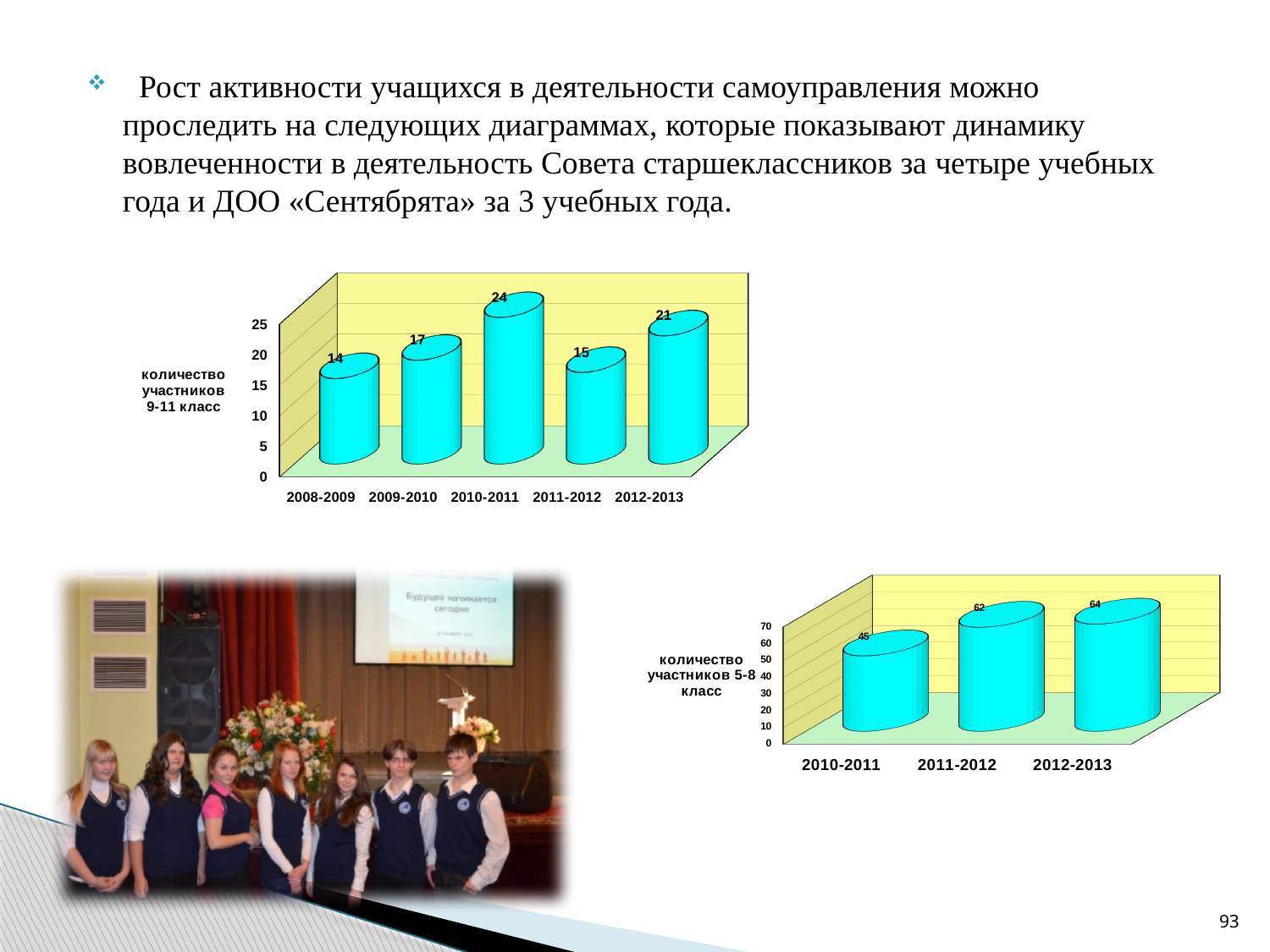
In the bottom-right chart (количество участников 5-8 класс), what is the difference between the values for 2011-2012 and 2010-2011? 17 In the top chart (количество участников 9-11 класс), which year has the highest value? 2010-2011 In the top chart (количество участников 9-11 класс), which is larger: the value for 2009-2010 or 2012-2013? 2012-2013 In the top chart (количество участников 9-11 класс), what is the value for 2010-2011? 24 In the top chart (количество участников 9-11 класс), what is the difference between the values for 2010-2011 and 2011-2012? 9 In the bottom-right chart (количество участников 5-8 класс), what is the value for 2012-2013? 64 How many categories (school years) are shown in the top chart (количество участников 9-11 класс)? 5 In the top chart (количество участников 9-11 класс), what is the value for 2008-2009? 14 In the bottom-right chart (количество участников 5-8 класс), do the values rise or fall from 2010-2011 to 2012-2013? rise What kind of chart is the bottom-right chart (количество участников 5-8 класс)? bar chart In the bottom-right chart (количество участников 5-8 класс), what is the value for 2010-2011? 45 In the top chart (количество участников 9-11 класс), which year has the lowest value? 2008-2009